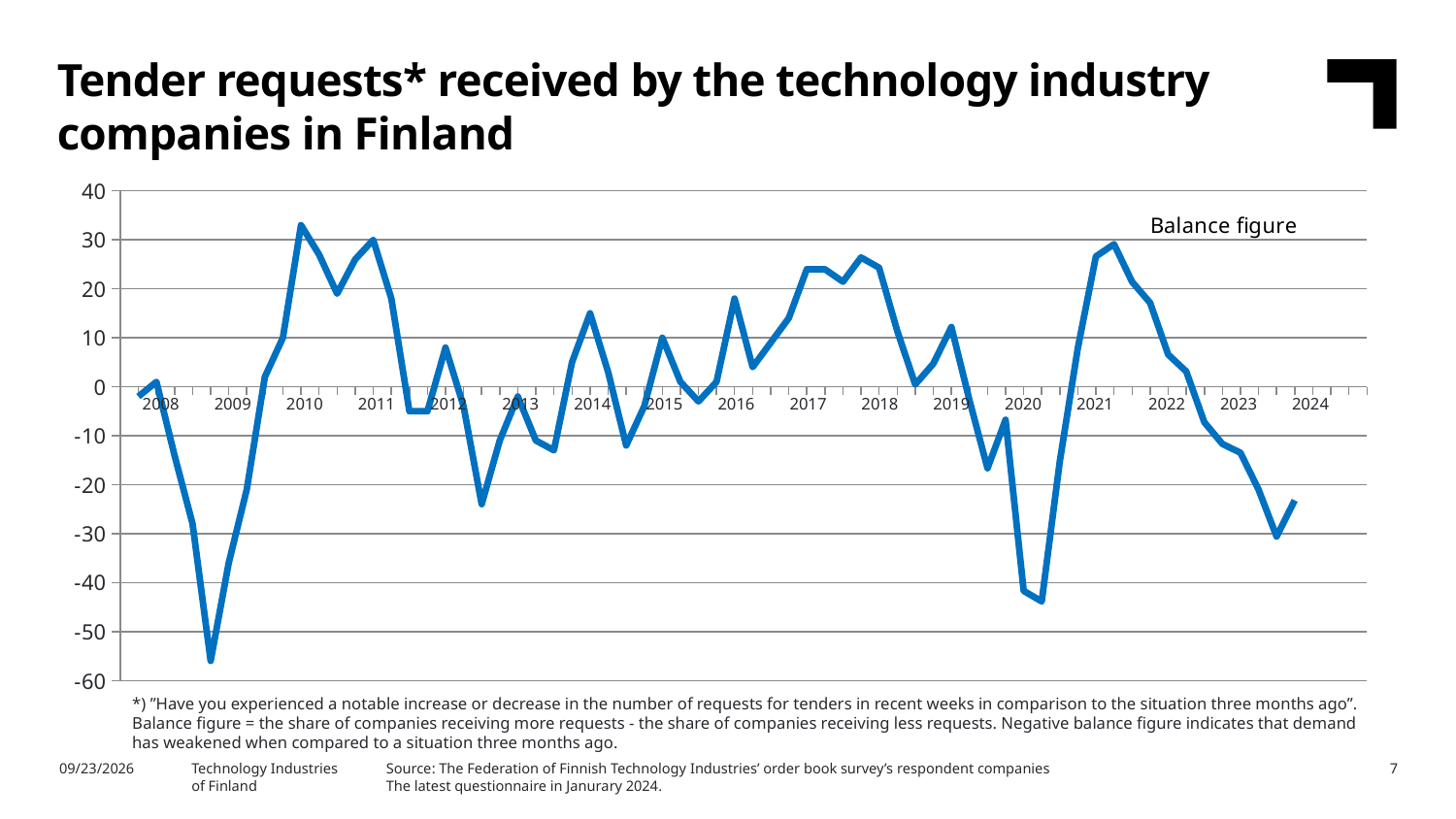
Is the peak value of the balance figure in 2021 greater or less than 20? greater What is the name of the series shown in the legend? Balance figure In which year does the balance figure reach its lowest point? 2009 Is the lowest value of the balance figure in 2012 greater or less than -20? less How many year labels are shown on the x axis? 17 Is the lowest value of the balance figure in early 2009 greater or less than -50? less How many series does the legend list? 1 Does the balance figure rise or fall between 2021 and 2023? fall What kind of chart is shown on the slide? line chart What is the title of the chart on the slide? Tender requests* received by the technology industry companies in Finland